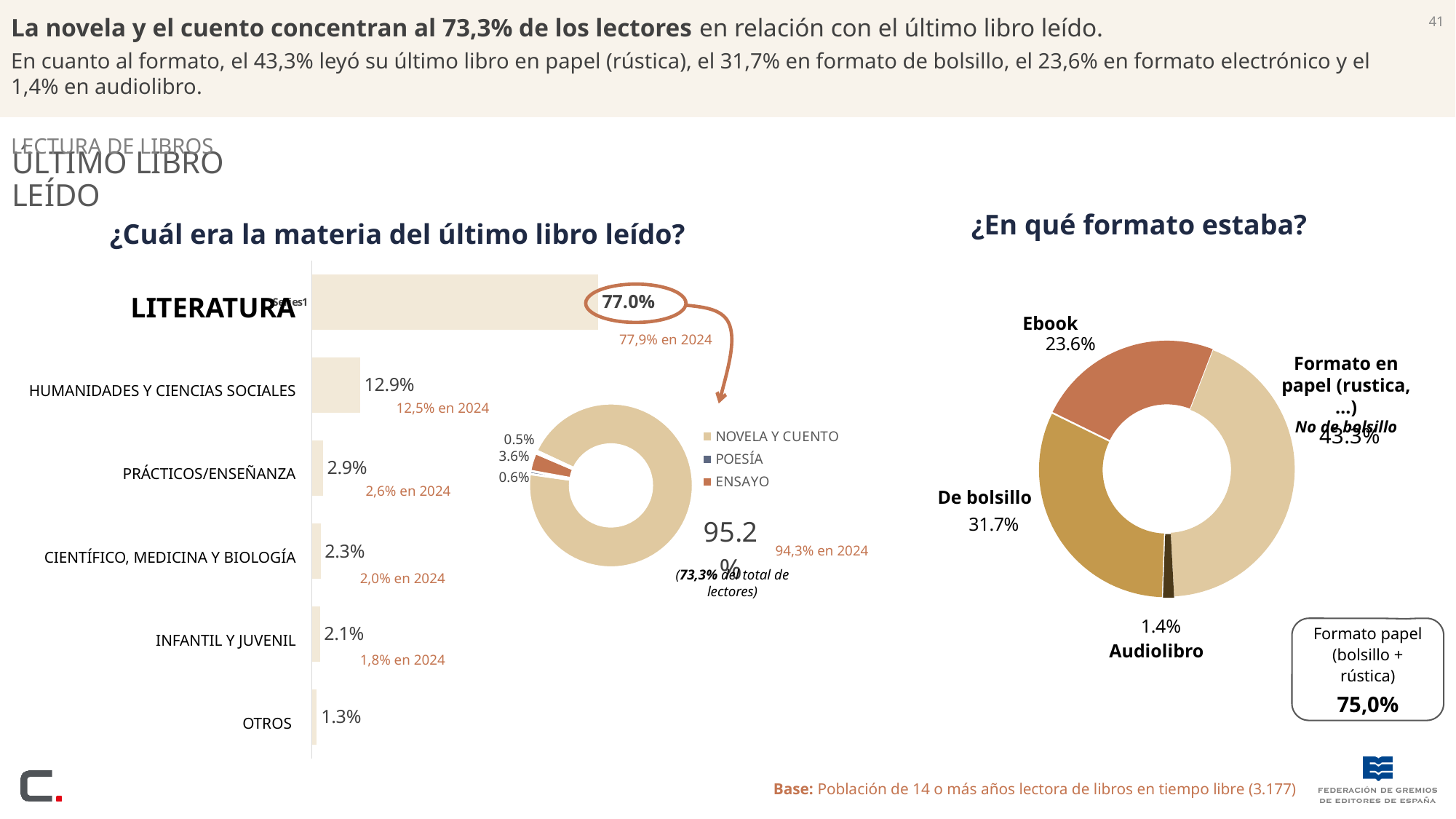
In the bar chart '¿Cuál era la materia del último libro leído?', what is the difference between LITERATURA and HUMANIDADES Y CIENCIAS SOCIALES? 64.1% In the chart '¿En qué formato estaba?', what is the value for Audiolibro? 1.4% In the bar chart '¿Cuál era la materia del último libro leído?', what is the value for INFANTIL Y JUVENIL? 2.1% In the bar chart '¿Cuál era la materia del último libro leído?', what is the value for LITERATURA? 77.0% In the bar chart '¿Cuál era la materia del último libro leído?', what is the value for HUMANIDADES Y CIENCIAS SOCIALES? 12.9% In the bar chart '¿Cuál era la materia del último libro leído?', how many categories are shown? 6 In the chart '¿En qué formato estaba?', which is larger: De bolsillo or Ebook? De bolsillo In the bar chart '¿Cuál era la materia del último libro leído?', which category has the lowest value? OTROS What kind of chart is '¿Cuál era la materia del último libro leído?'? Bar chart How many entries does the legend of the small donut chart next to the bar chart list? 3 In the bar chart '¿Cuál era la materia del último libro leído?', which category has the highest value? LITERATURA In the chart '¿En qué formato estaba?', what is the value for Ebook? 23.6%